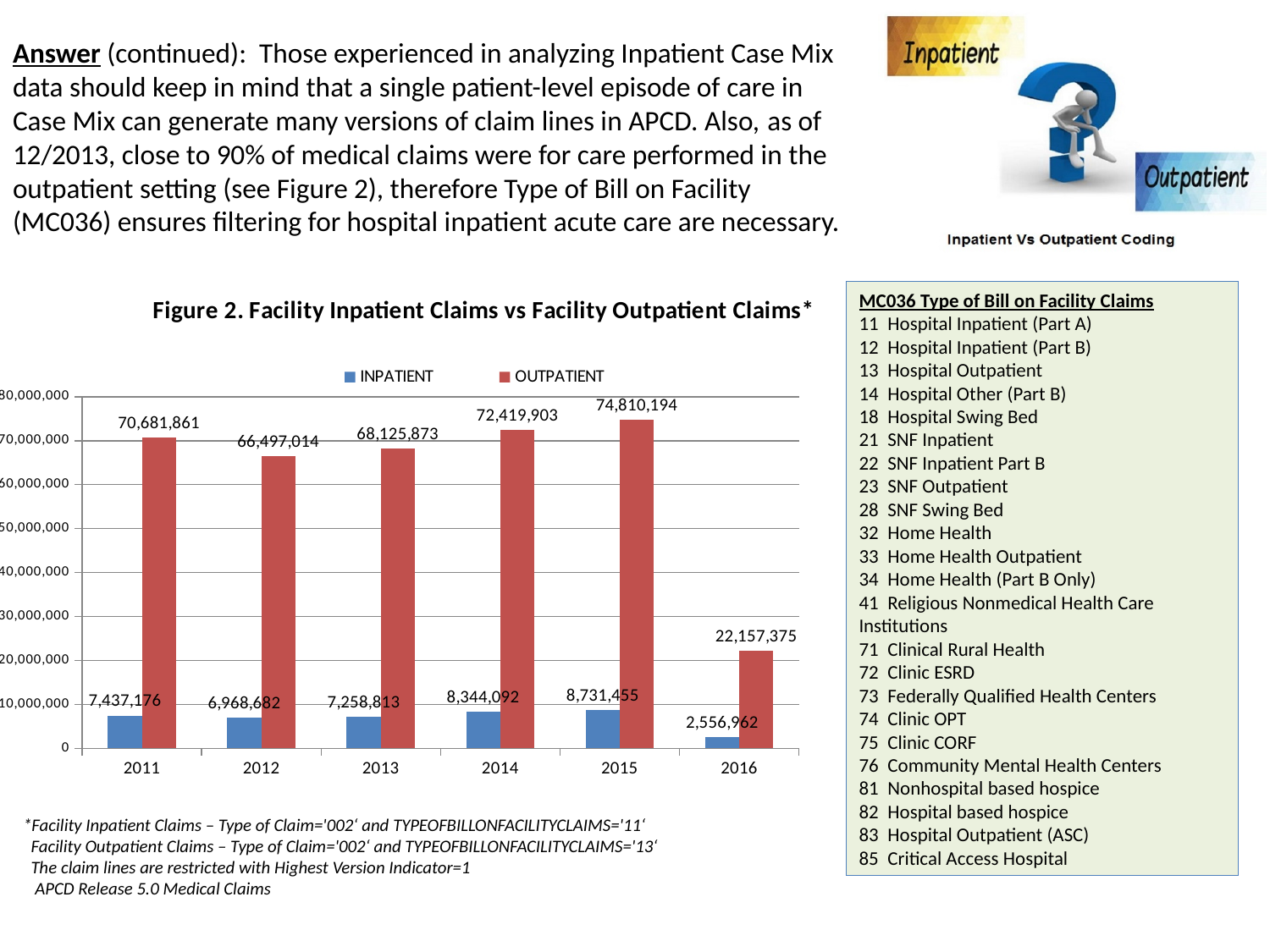
What is the difference between the OUTPATIENT values for 2011 and 2012? 4,184,847 What kind of chart is shown in Figure 2? bar chart Which is larger, the INPATIENT value for 2013 or the INPATIENT value for 2014? 2014 How many years are shown on the x axis? 6 What is the OUTPATIENT value for 2011? 70,681,861 What is the INPATIENT value for 2014? 8,344,092 How many series does the legend list? 2 What is the OUTPATIENT value for 2016? 22,157,375 Is the OUTPATIENT value for 2013 greater or less than 60,000,000? greater Which year has the highest OUTPATIENT value? 2015 Which year has the lowest INPATIENT value? 2016 What is the difference between the OUTPATIENT and INPATIENT values in 2015? 66,078,739